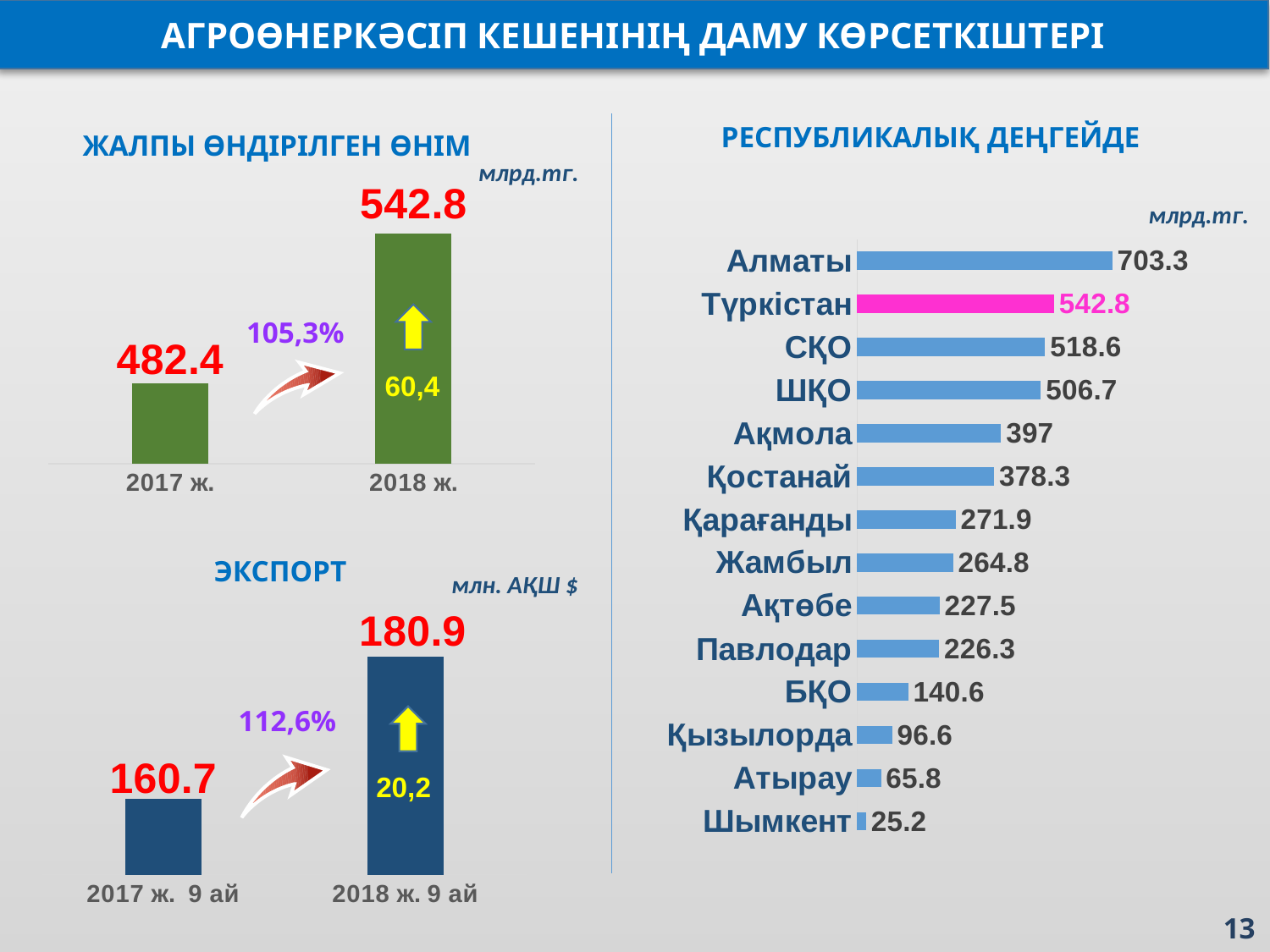
In the "ЭКСПОРТ" chart, what percentage growth is shown between the two bars? 112,6% In the "ЖАЛПЫ ӨНДІРІЛГЕН ӨНІМ" chart, what is the difference between the 2018 ж. and 2017 ж. values? 60.4 In the "РЕСПУБЛИКАЛЫҚ ДЕҢГЕЙДЕ" chart, which region has the highest value? Алматы In the "РЕСПУБЛИКАЛЫҚ ДЕҢГЕЙДЕ" chart, how many regions are listed? 14 In the "РЕСПУБЛИКАЛЫҚ ДЕҢГЕЙДЕ" chart, what is the difference between the values for Алматы and Түркістан? 160.5 In the "ЖАЛПЫ ӨНДІРІЛГЕН ӨНІМ" chart, what is the value for 2018 ж.? 542.8 In the "РЕСПУБЛИКАЛЫҚ ДЕҢГЕЙДЕ" chart, which region has the lowest value? Шымкент In the "РЕСПУБЛИКАЛЫҚ ДЕҢГЕЙДЕ" chart, what is the value for Ақмола? 397 In the "ЭКСПОРТ" chart, what is the value for 2017 ж. 9 ай? 160.7 In the "ЖАЛПЫ ӨНДІРІЛГЕН ӨНІМ" chart, what unit is shown for the values? млрд.тг. In the "ЭКСПОРТ" chart, do the values rise or fall from 2017 ж. 9 ай to 2018 ж. 9 ай? rise What kind of chart is the "РЕСПУБЛИКАЛЫҚ ДЕҢГЕЙДЕ" chart? bar chart